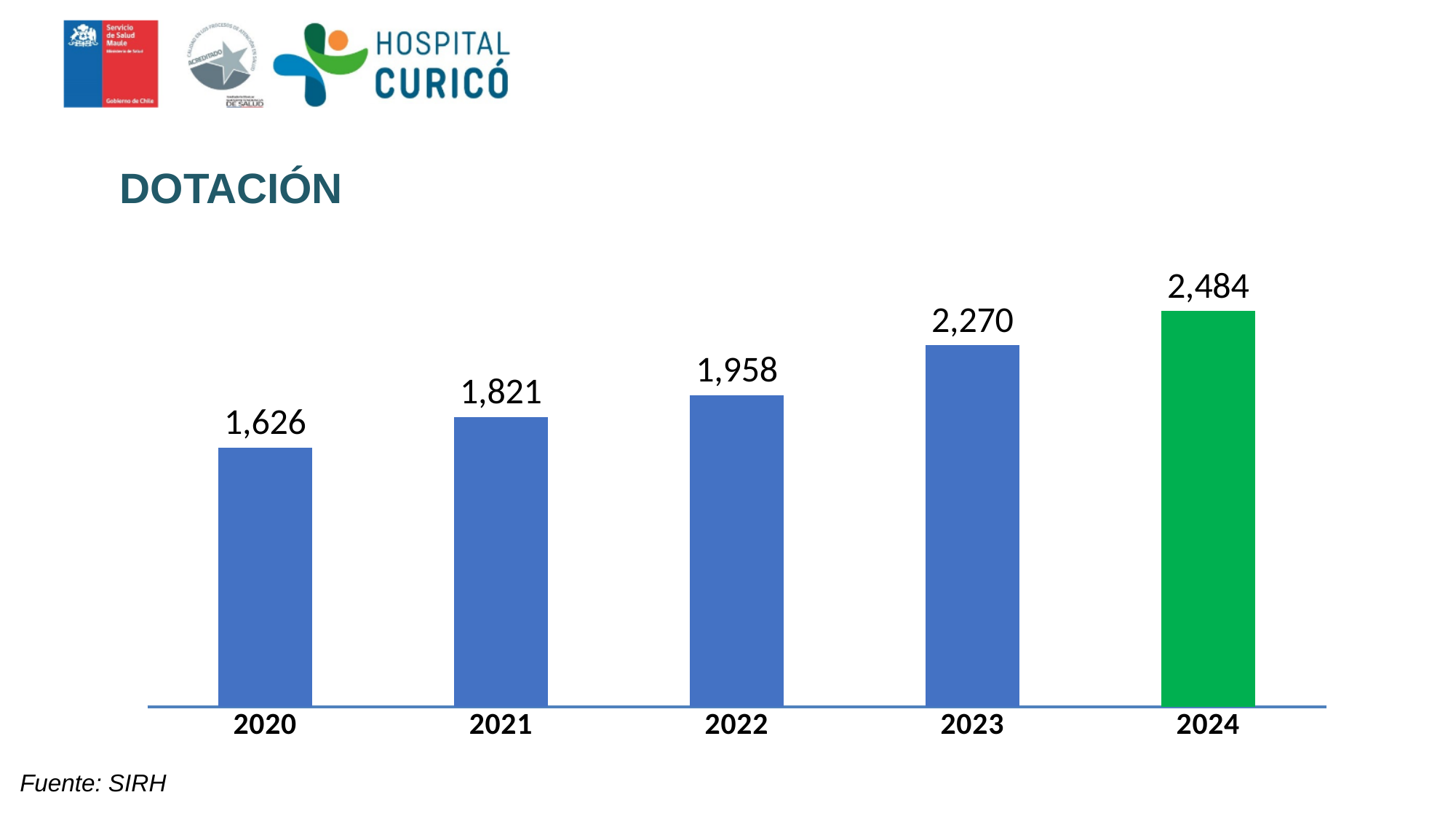
What kind of chart is shown on the slide? Bar chart What is the difference between the values for 2024 and 2023? 214 Which bar is coloured green rather than blue? 2024 How many years are shown on the chart? 5 Which year has the highest value? 2024 Which year has the lowest value? 2020 What is the value for 2024? 2,484 What is the difference between the values for 2021 and 2020? 195 What is the value for 2022? 1,958 Which is larger, the value for 2022 or the value for 2021? 2022 Do the values rise or fall from 2020 to 2024? Rise What is the value for 2020? 1,626